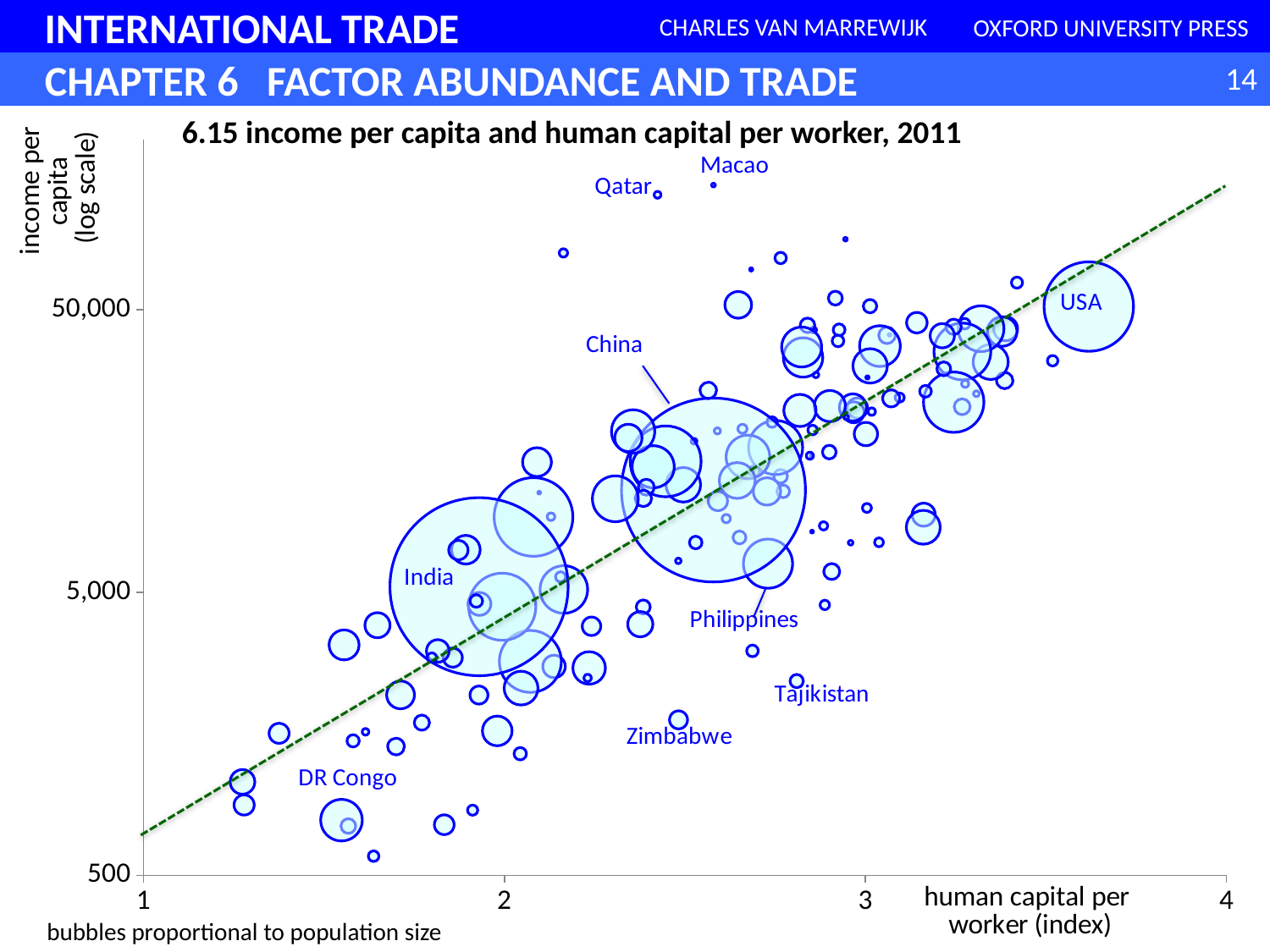
Is the income per capita for Macao greater or less than 50,000? greater Is the human capital per worker index for India greater or less than 2? less What is the title of the chart? 6.15 income per capita and human capital per worker, 2011 Which has the higher income per capita, Macao or DR Congo? Macao What does the size of each bubble represent? population size Does income per capita generally rise or fall as human capital per worker increases? rise Is the income per capita for DR Congo greater or less than 5,000? less What kind of chart is shown on the slide? bubble chart (scatter plot) Which has the higher human capital per worker index, the USA or India? USA